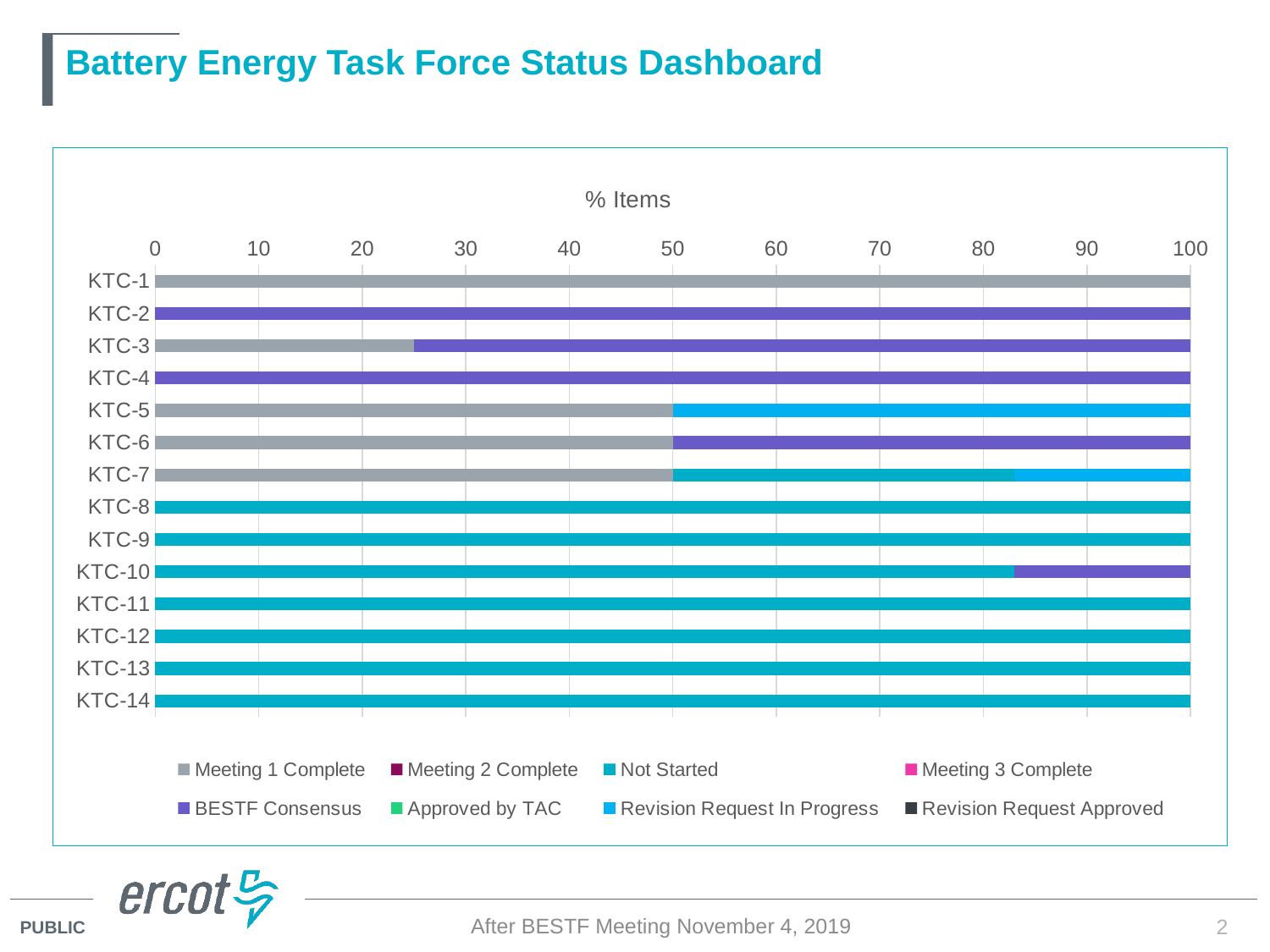
Is the Not Started segment for KTC-7 greater or less than 80? less How many categories (KTC items) are plotted on the chart? 14 What kind of chart is shown on the slide? Stacked bar chart What is the value of the Meeting 1 Complete segment for KTC-5? 50 What is the total length of the KTC-1 bar? 100 How many series does the legend list? 8 Which series makes up the entire bar for KTC-2? BESTF Consensus What is the value of the Meeting 1 Complete segment for KTC-1? 100 What is the value of the Meeting 1 Complete segment for KTC-6? 50 Is the Meeting 1 Complete segment for KTC-3 greater or less than 30? less Which is larger: the Meeting 1 Complete segment for KTC-3 or the Meeting 1 Complete segment for KTC-5? KTC-5 What is the title of the chart? % Items